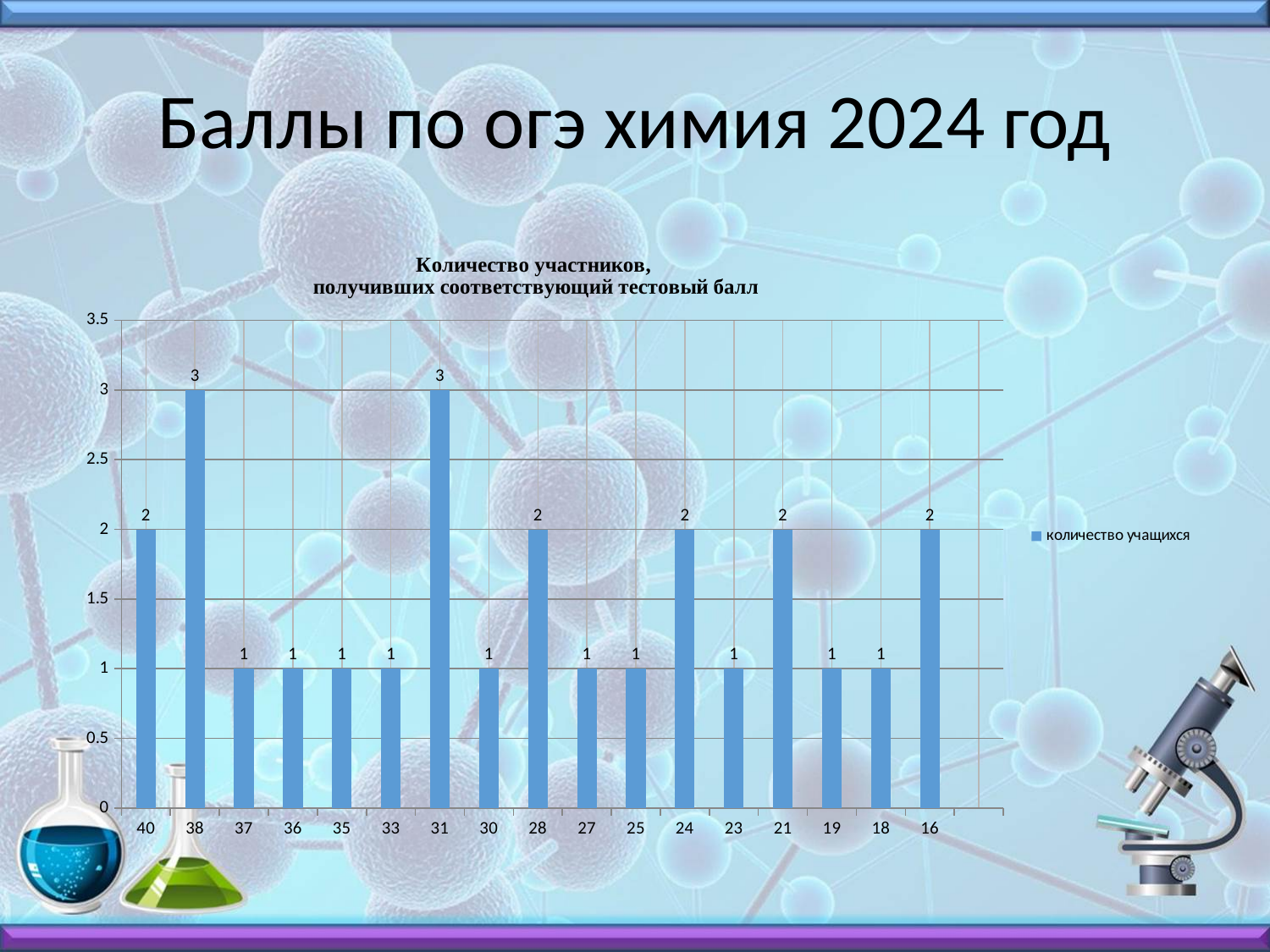
Which has a larger value, score 28 or score 27? 28 What is the value shown for score 23? 1 How many participants received a score of 16? 2 How many score categories are shown on the x axis? 17 What is the value of the bar for score 31? 3 How many series does the legend list? 1 What kind of chart is shown on the slide? bar chart Which has a larger value, score 40 or score 38? 38 How many participants received a test score of 40? 2 Is the value for score 38 greater or less than 2.5? greater What is the difference between the values for score 38 and score 37? 2 What is the highest value reached by any bar in the chart? 3